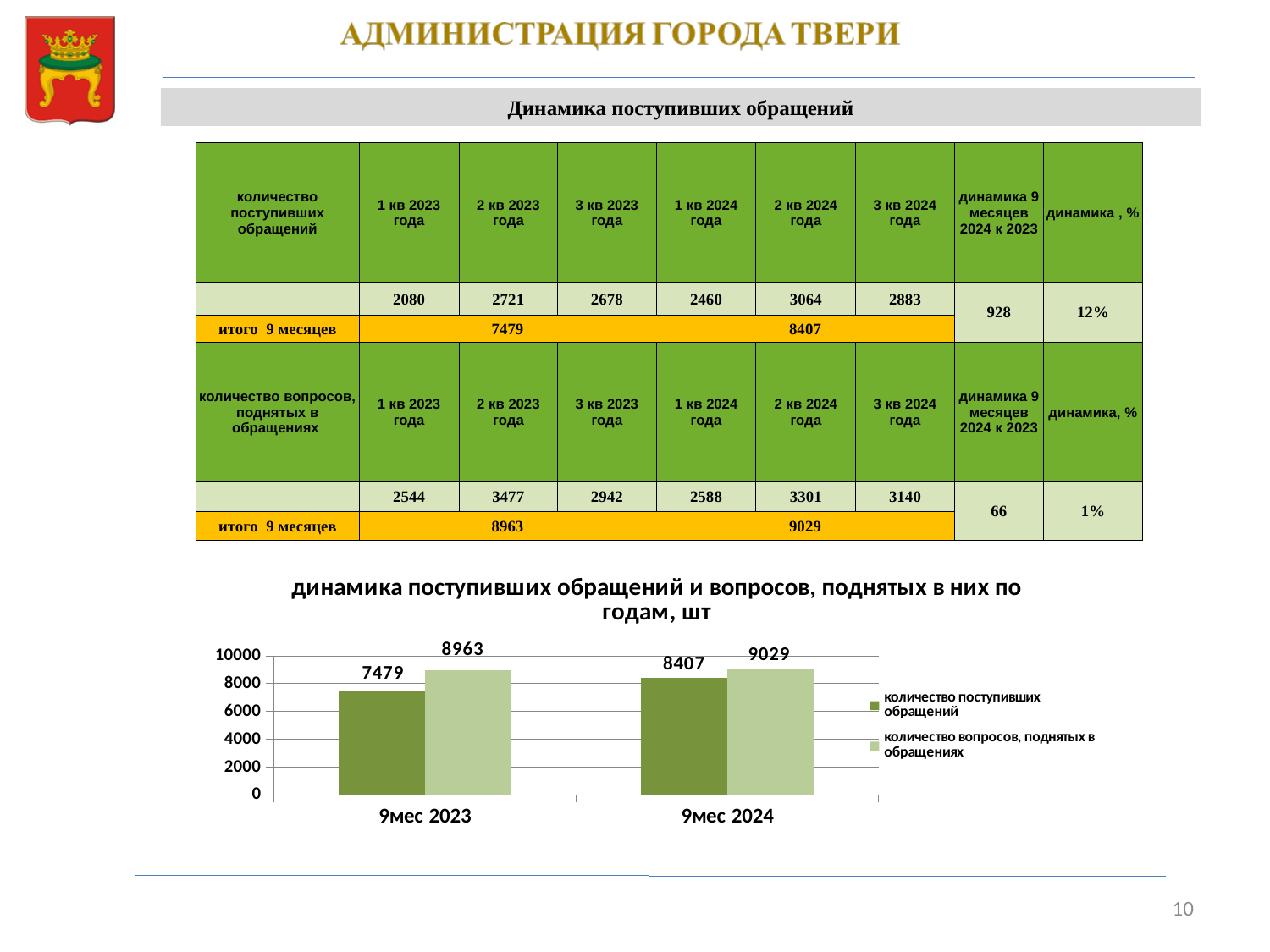
What is the value for 'количество поступивших обращений' in 9мес 2024? 8407 What type of chart is shown on the slide? bar chart How many series does the legend list? 2 How many categories are shown on the x axis? 2 What is the value for 'количество вопросов, поднятых в обращениях' in 9мес 2023? 8963 What is the title of the chart? динамика поступивших обращений и вопросов, поднятых в них по годам, шт What is the value for 'количество поступивших обращений' in 9мес 2023? 7479 What is the difference between 'количество вопросов, поднятых в обращениях' in 9мес 2024 and 9мес 2023? 66 Which is larger in 9мес 2023: 'количество поступивших обращений' or 'количество вопросов, поднятых в обращениях'? количество вопросов, поднятых в обращениях What is the value for 'количество вопросов, поднятых в обращениях' in 9мес 2024? 9029 What is the difference between 'количество поступивших обращений' in 9мес 2024 and 9мес 2023? 928 Does 'количество поступивших обращений' rise or fall from 9мес 2023 to 9мес 2024? rise